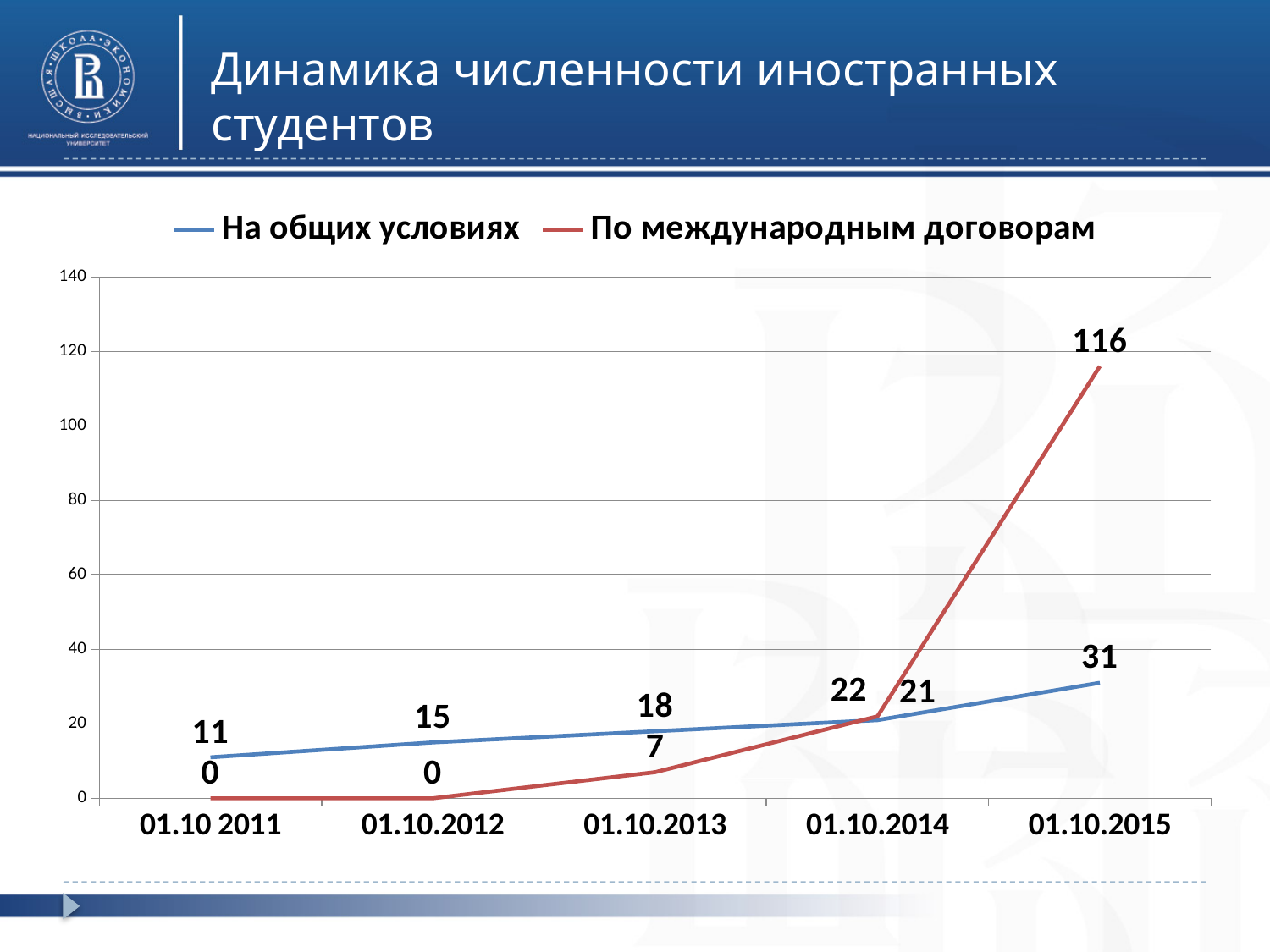
What is the title of the chart on the slide? Динамика численности иностранных студентов What type of chart is shown on the slide? line chart How many dates are shown on the x axis? 5 How many series does the legend list? 2 On which dates is the value for 'По международным договорам' lowest? 01.10 2011 and 01.10.2012 What is the difference between the two series on 01.10.2015? 85 What is the value for 'По международным договорам' on 01.10.2015? 116 On which date is the value for 'На общих условиях' highest? 01.10.2015 Which series has the larger value on 01.10.2013? На общих условиях Does the value for 'На общих условиях' rise or fall from 01.10 2011 to 01.10.2015? rise What is the value for 'На общих условиях' on 01.10.2013? 18 What is the value for 'По международным договорам' on 01.10.2014? 22